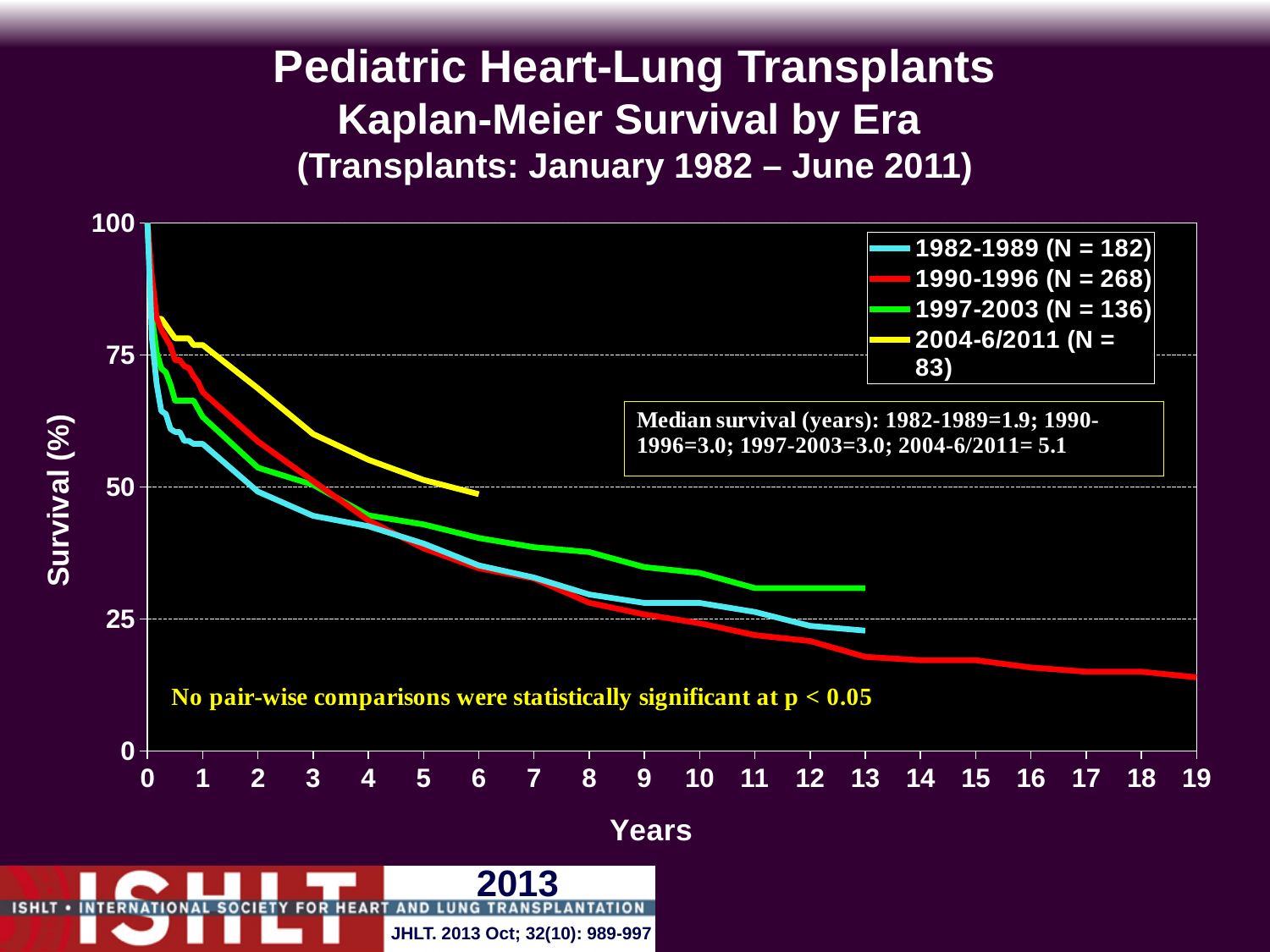
At 10 years, which era has higher survival: 1997-2003 or 1990-1996? 1997-2003 Is the survival value for the 1990-1996 era at 19 years greater or less than 25? less How many transplants (N) are in the 1990-1996 era? 268 What kind of chart is shown on the slide? line chart Do the survival curves rise or fall as years increase? fall How many series does the legend list? 4 What is the difference in median survival (years) between the 2004-6/2011 era and the 1982-1989 era? 3.2 Which era has the highest median survival? 2004-6/2011 What is the median survival in years for the 1982-1989 era? 1.9 Which era has the lowest median survival? 1982-1989 What is the median survival in years for the 2004-6/2011 era? 5.1 Is the survival value for the 1997-2003 era at 13 years greater or less than 25? greater